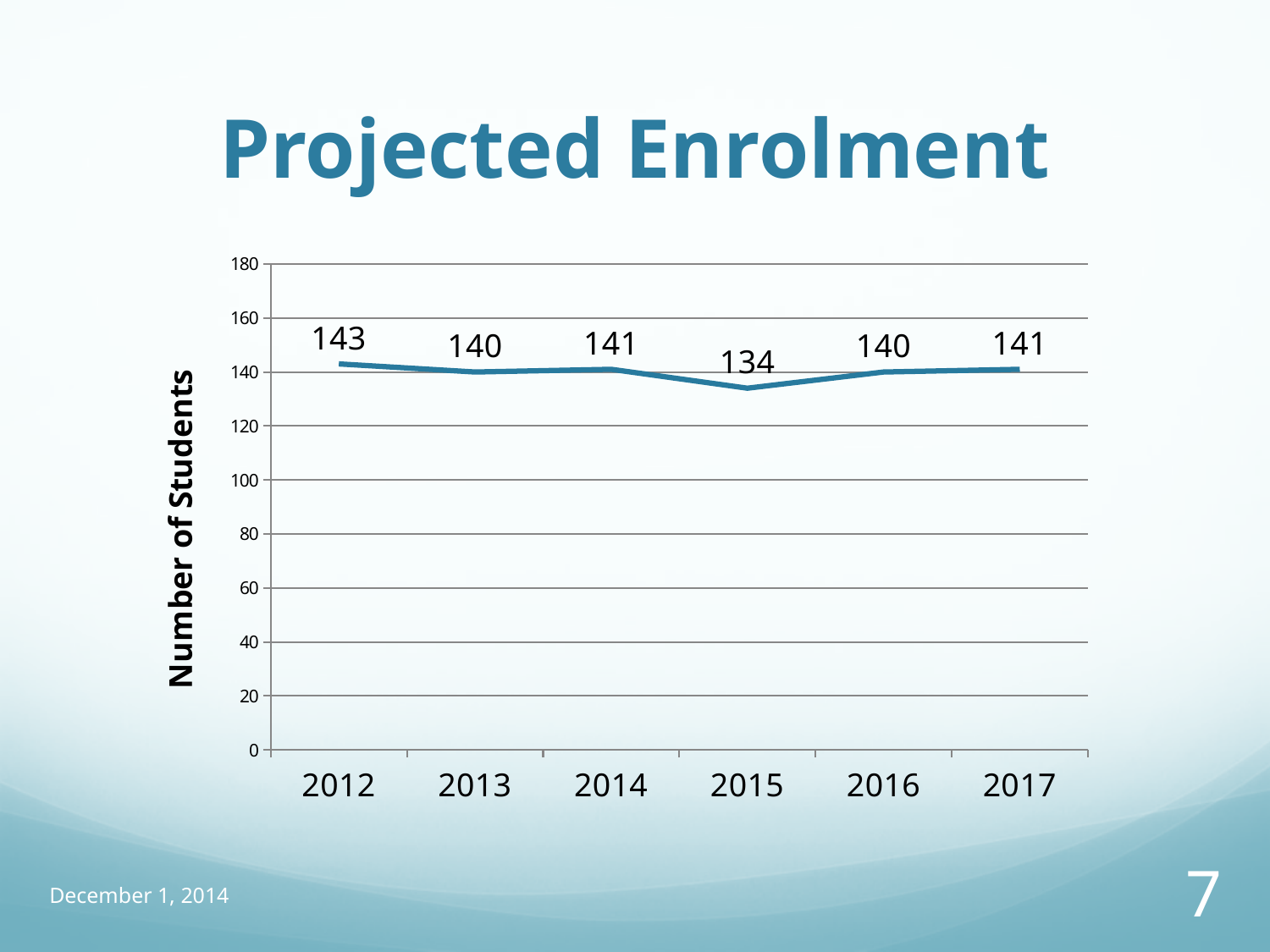
How many years are plotted on the chart? 6 Is the projected enrolment for 2015 greater or less than 140? less What kind of chart is shown on the slide? line chart What is the label on the vertical axis of the chart? Number of Students What is the projected enrolment for 2015? 134 What is the projected enrolment for 2017? 141 Does the projected enrolment rise or fall from 2015 to 2016? rise Which year has a larger projected enrolment, 2014 or 2015? 2014 What is the projected enrolment for 2012? 143 What is the difference between the projected enrolment in 2012 and 2015? 9 Which year has the highest projected enrolment? 2012 Which year has the lowest projected enrolment? 2015